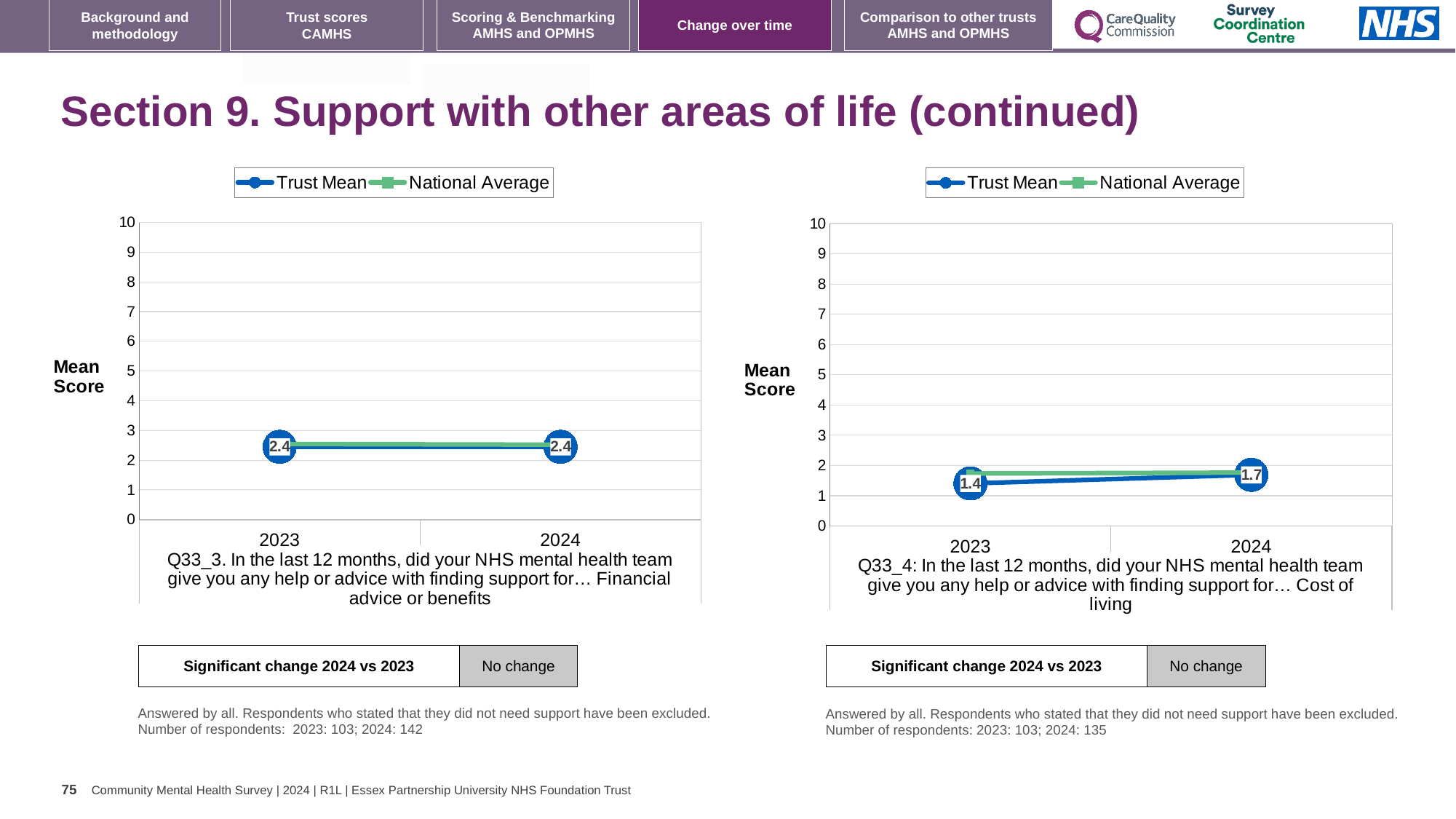
What type of chart is used on the left of the slide (Q33_3)? line chart On the left chart (Q33_3, Financial advice or benefits), what is the Trust Mean score for 2024? 2.4 On the right chart (Q33_4, Cost of living), what is the Trust Mean score for 2023? 1.4 On the right chart (Q33_4, Cost of living), is the National Average for 2023 greater or less than 3? less On the left chart (Q33_3, Financial advice or benefits), does the Trust Mean rise, fall or stay the same from 2023 to 2024? stay the same What is the label of the y axis on the left chart (Q33_3)? Mean Score On the right chart (Q33_4, Cost of living), does the Trust Mean rise or fall from 2023 to 2024? rise How many years are plotted on the x axis of the left chart (Q33_3)? 2 How many series does the legend of the right chart (Q33_4) list? 2 On the left chart (Q33_3, Financial advice or benefits), what is the Trust Mean score for 2023? 2.4 On the right chart (Q33_4, Cost of living), what is the Trust Mean score for 2024? 1.7 On the right chart (Q33_4, Cost of living), by how much did the Trust Mean change from 2023 to 2024? 0.3